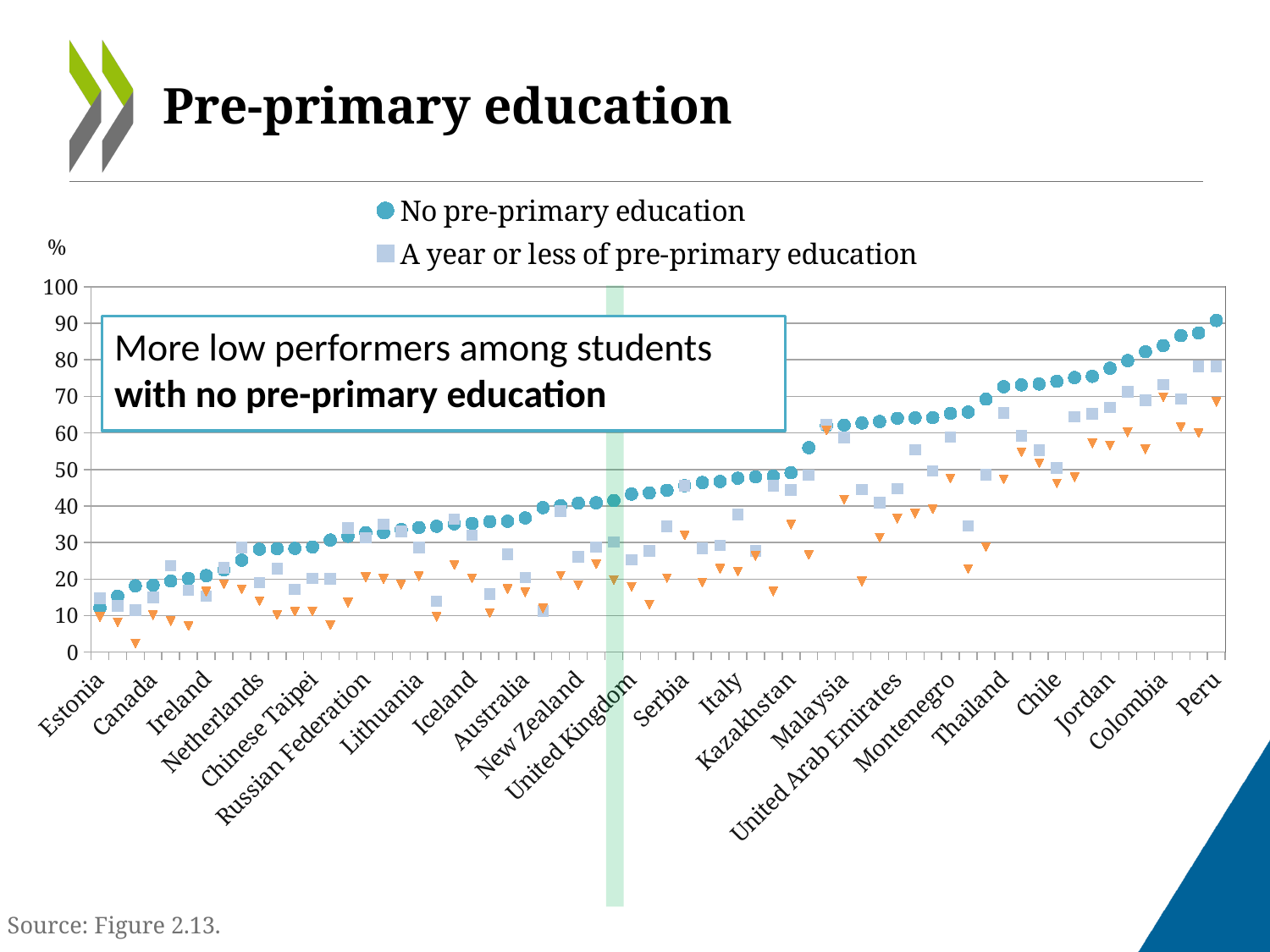
Which country is highlighted with a green vertical band on the chart? United Kingdom Is the 'No pre-primary education' value for Colombia greater or less than 80? greater Is the 'No pre-primary education' value for the United Kingdom greater or less than 50? less What kind of chart is shown on the slide? Scatter chart Do the values for 'No pre-primary education' rise or fall from left to right along the x axis? Rise Which country has the lowest value for the 'No pre-primary education' series? Estonia For Peru, which is larger: the 'No pre-primary education' value or the 'A year or less of pre-primary education' value? No pre-primary education Which country has the highest value for the 'No pre-primary education' series? Peru What is the title of the slide's chart? Pre-primary education Is the 'No pre-primary education' value for Peru greater or less than 80? greater How many series does the chart's legend list? 2